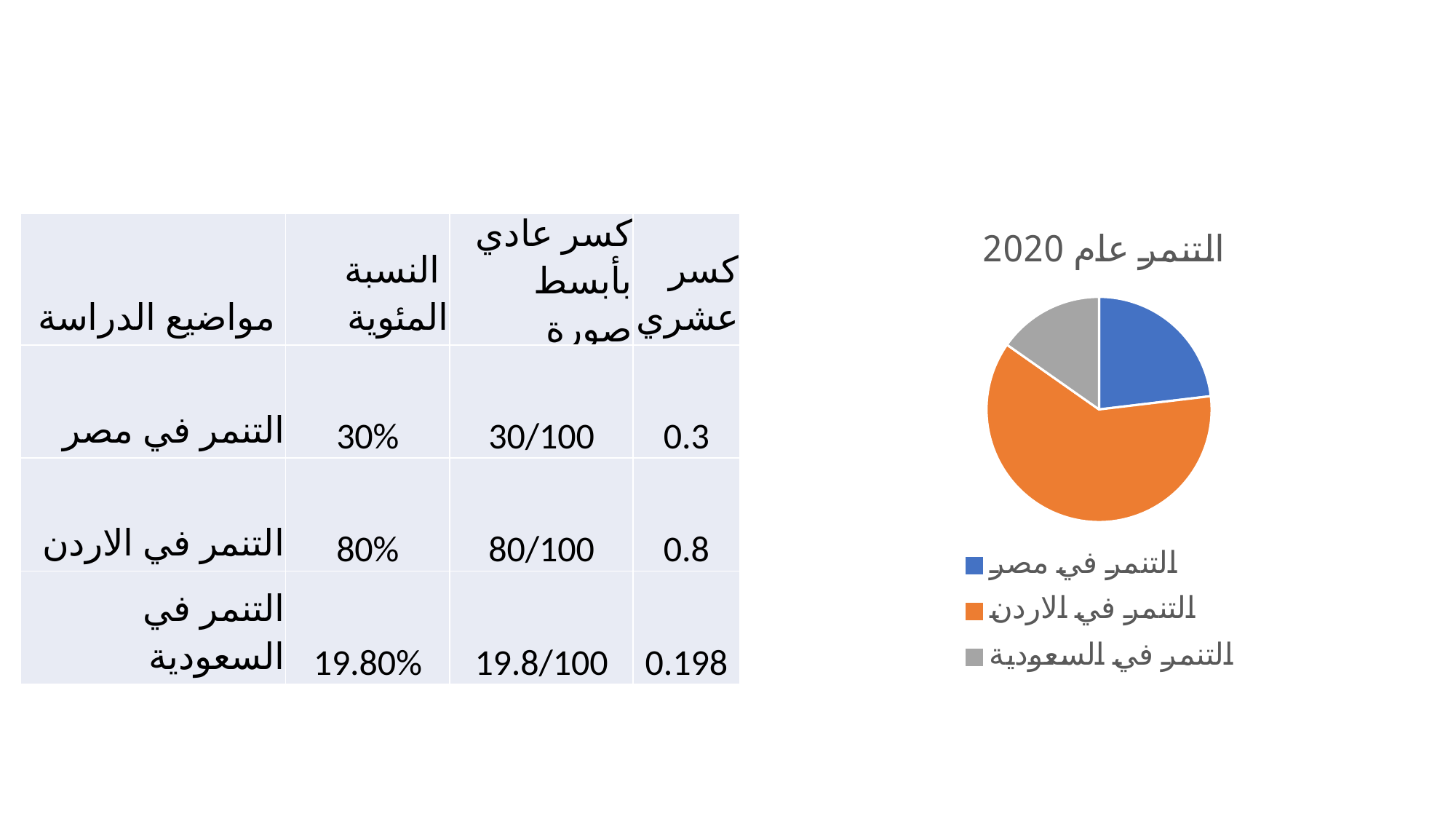
How many entries does the pie chart's legend list? 3 In the pie chart, which slice is larger: التنمر في مصر or التنمر في السعودية? التنمر في مصر Which category has the smallest slice in the pie chart? التنمر في السعودية Is the share of the pie for التنمر في الاردن greater or less than 50%? greater What kind of chart is shown on the slide? pie chart What colour is the slice for التنمر في الاردن in the pie chart? orange How many slices does the pie chart have? 3 What is the title of the pie chart? التنمر عام 2020 Which category has the largest slice in the pie chart? التنمر في الاردن In the pie chart, which slice is larger: التنمر في الاردن or التنمر في مصر? التنمر في الاردن